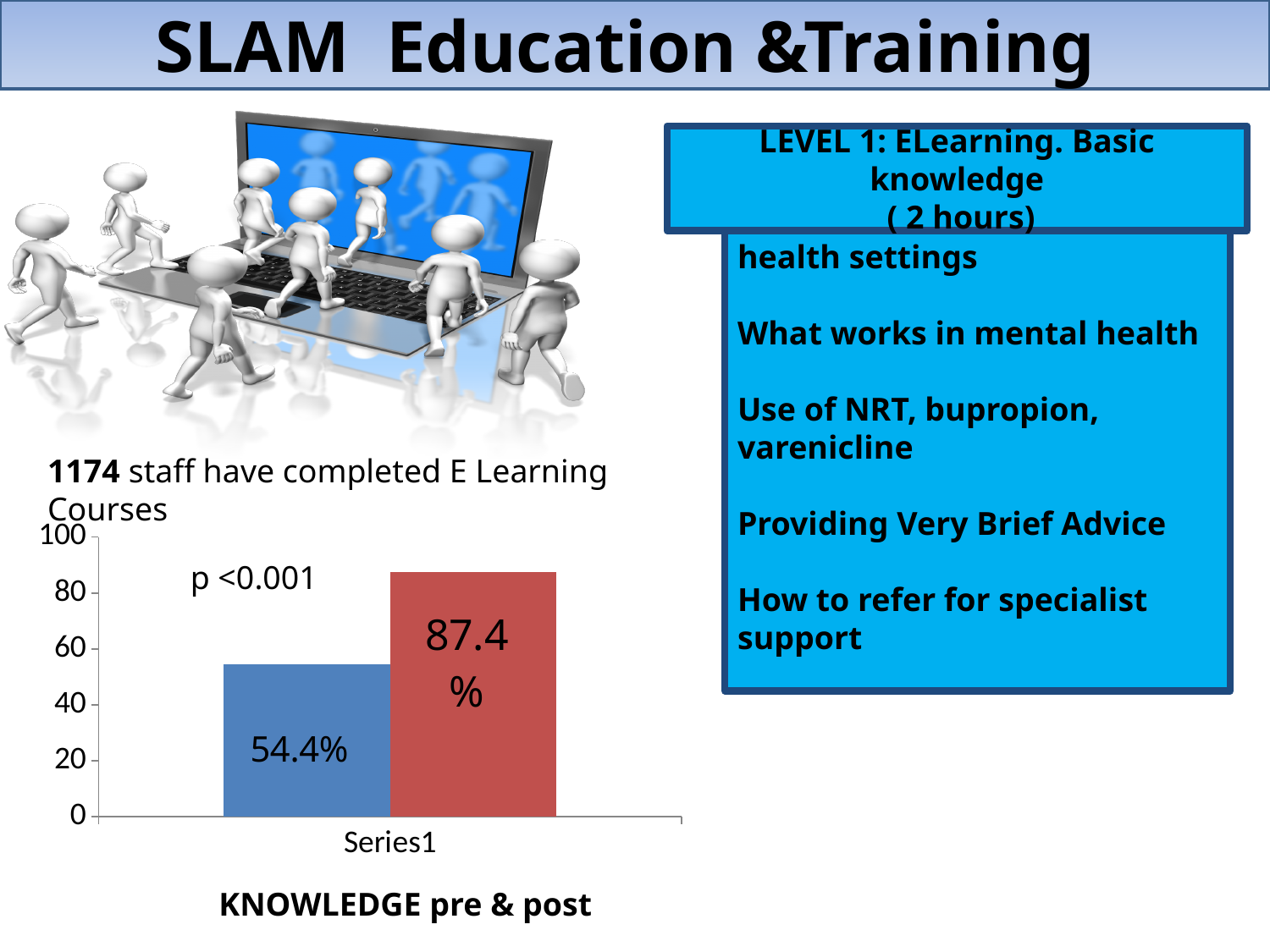
What is the difference between the red bar value and the blue bar value? 33% Which bar has the lowest value in the chart? the blue bar (54.4%) What value is shown on the blue bar in the chart? 54.4% Is the value of the blue bar greater or less than 60? less What kind of chart is shown on the slide? bar chart How many bars are plotted in the chart? 2 What p-value is annotated on the chart? p <0.001 What is the highest value shown on the chart's vertical axis? 100 What value is shown on the red bar in the chart? 87.4% Is the value of the red bar greater or less than 80? greater What category label appears under the bars on the x axis? Series1 Which bar is taller, the blue bar or the red bar? the red bar